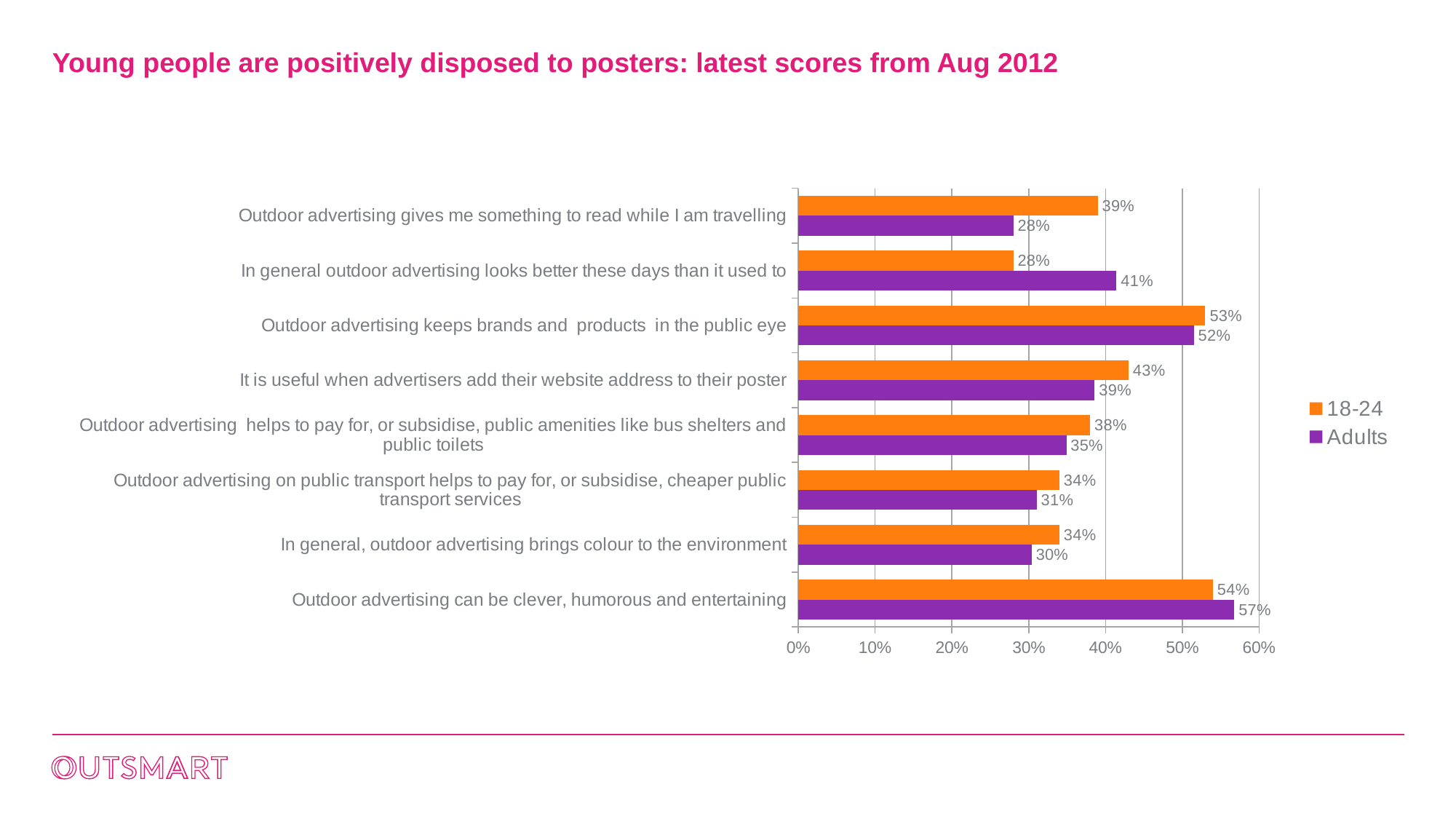
What is the Adults value for "In general outdoor advertising looks better these days than it used to"? 41% Which statement has the highest 18-24 value? Outdoor advertising can be clever, humorous and entertaining What is the difference between the 18-24 and Adults values for "Outdoor advertising gives me something to read while I am travelling"? 11% How many series does the legend list? 2 What kind of chart is shown on the slide? Bar chart Is the Adults value for "Outdoor advertising keeps brands and products in the public eye" greater or less than 50%? greater For "In general outdoor advertising looks better these days than it used to", which is larger: the 18-24 value or the Adults value? Adults What is the 18-24 value for "Outdoor advertising gives me something to read while I am travelling"? 39% Which colour represents the Adults series? Purple How many statements are shown on the chart? 8 Which statement has the lowest Adults value? Outdoor advertising gives me something to read while I am travelling What is the Adults value for "Outdoor advertising can be clever, humorous and entertaining"? 57%